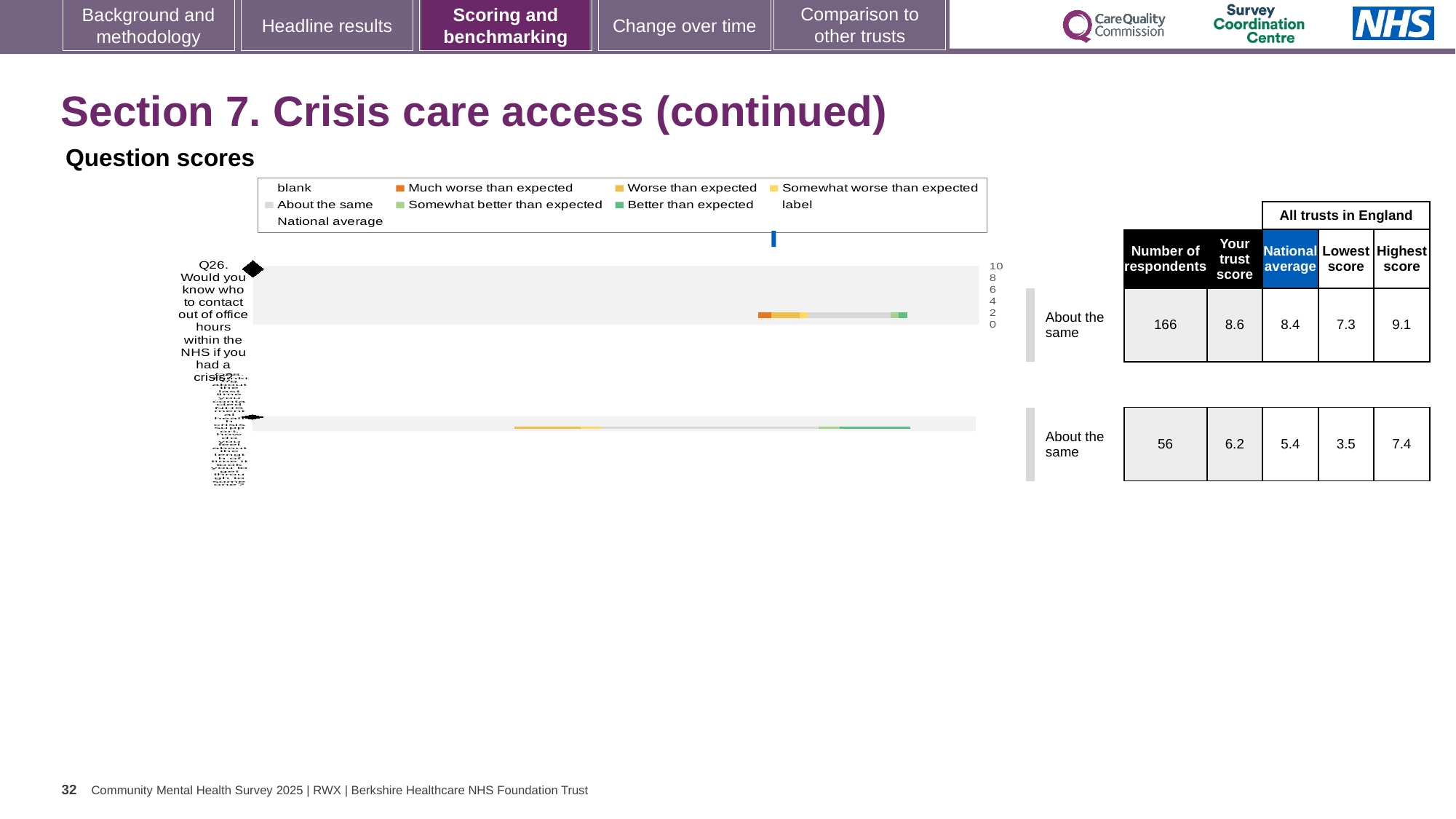
According to the table beside the chart, what is the national average for Q26? 8.4 What benchmark category is shown for Q26? About the same According to the table beside the chart, how many respondents answered Q26? 166 For Q26, what is the difference between the highest score and the lowest score across all trusts in England? 1.8 What kind of chart is shown under 'Question scores'? bar chart According to the table beside the chart, what is the trust score for Q26? 8.6 What is the highest tick value shown on the chart's score axis? 10 What colour does the legend use for 'Much worse than expected'? orange How many question bars are plotted in the chart? 2 For Q26, which is larger: the trust score or the national average? the trust score